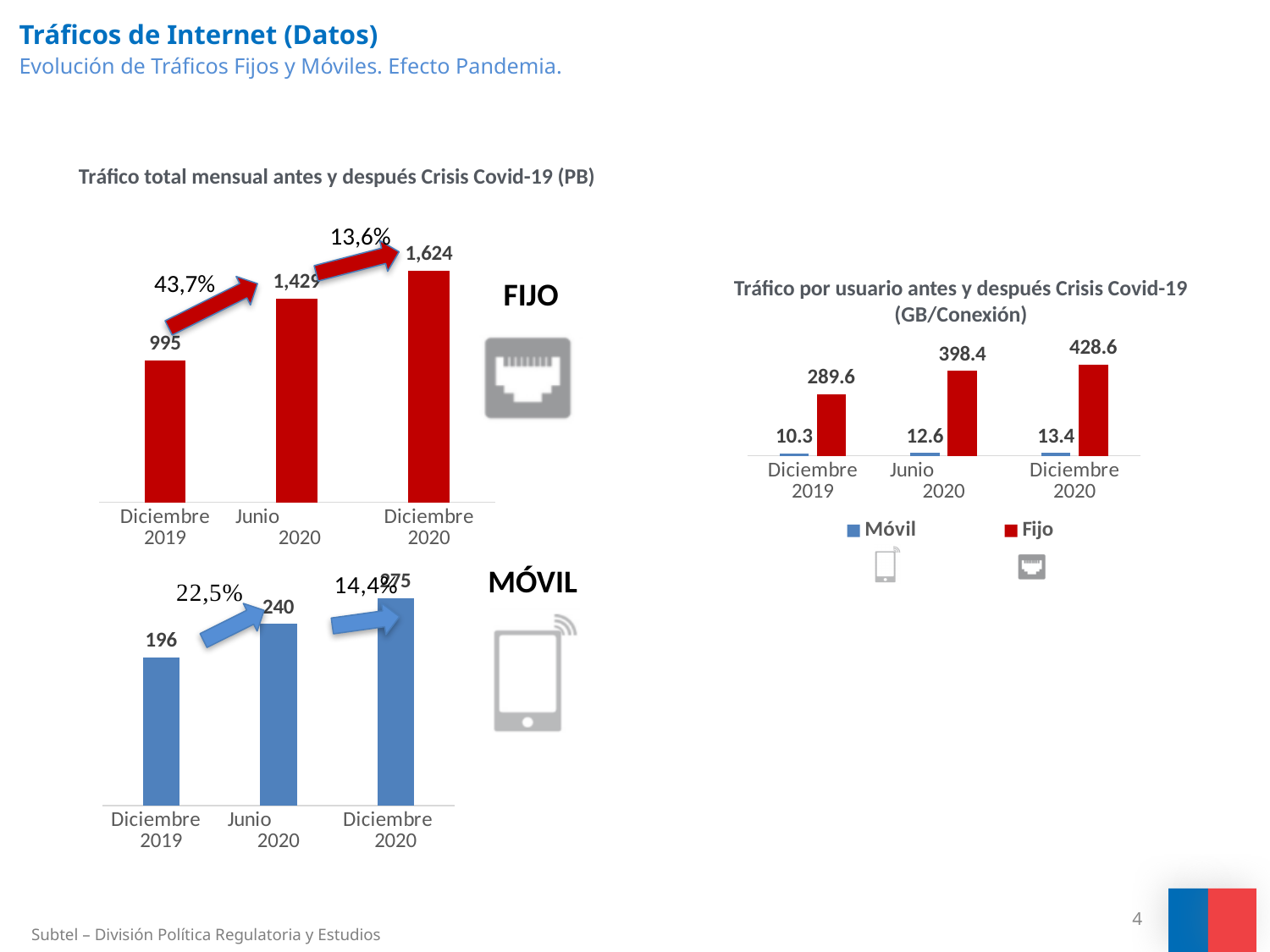
In the FIJO chart (top left), what is the value for Diciembre 2019? 995 In the chart 'Tráfico por usuario antes y después Crisis Covid-19 (GB/Conexión)', what is the Fijo value for Junio 2020? 398.4 In the MÓVIL chart (bottom left), which period has the lowest value? Diciembre 2019 In the chart 'Tráfico por usuario antes y después Crisis Covid-19 (GB/Conexión)', which period has the highest Fijo value? Diciembre 2020 In the MÓVIL chart (bottom left), what is the value for Junio 2020? 240 In the FIJO chart (top left), what is the difference between the Junio 2020 and Diciembre 2019 values? 434 In the FIJO chart (top left), what is the value for Diciembre 2020? 1,624 In the chart 'Tráfico por usuario antes y después Crisis Covid-19 (GB/Conexión)', what is the Móvil value for Diciembre 2020? 13.4 What kind of chart is the FIJO chart (top left)? bar chart In the chart 'Tráfico por usuario antes y después Crisis Covid-19 (GB/Conexión)', how many series does the legend list? 2 In the FIJO chart (top left), what percentage increase is shown between Diciembre 2019 and Junio 2020? 43,7% In the MÓVIL chart (bottom left), do the values rise or fall from Diciembre 2019 to Diciembre 2020? rise